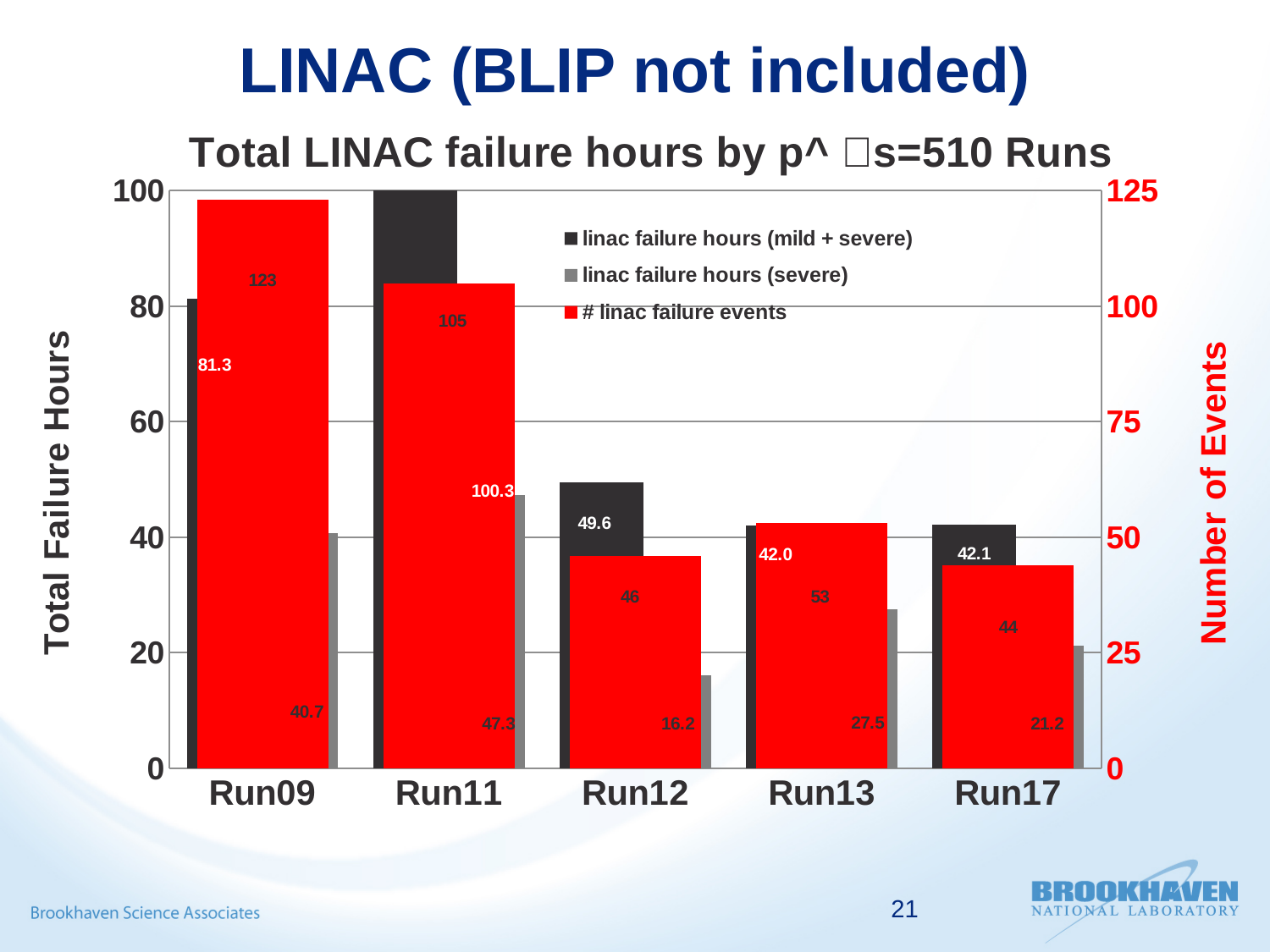
What is the value of linac failure hours (severe) for Run13? 27.5 Which run has more linac failure hours (severe), Run09 or Run11? Run11 How many series does the legend list? 3 Which run has the lowest linac failure hours (severe)? Run12 How many linac failure events are shown for Run11? 105 What is the value of linac failure hours (mild + severe) for Run17? 42.1 Which run has the highest number of linac failure events? Run09 What is the difference between the number of linac failure events for Run09 and Run11? 18 Which run has the highest linac failure hours (mild + severe)? Run11 What is the value of linac failure hours (mild + severe) for Run09? 81.3 How many runs are shown on the x axis? 5 What is the difference between linac failure hours (mild + severe) and linac failure hours (severe) for Run12? 33.4